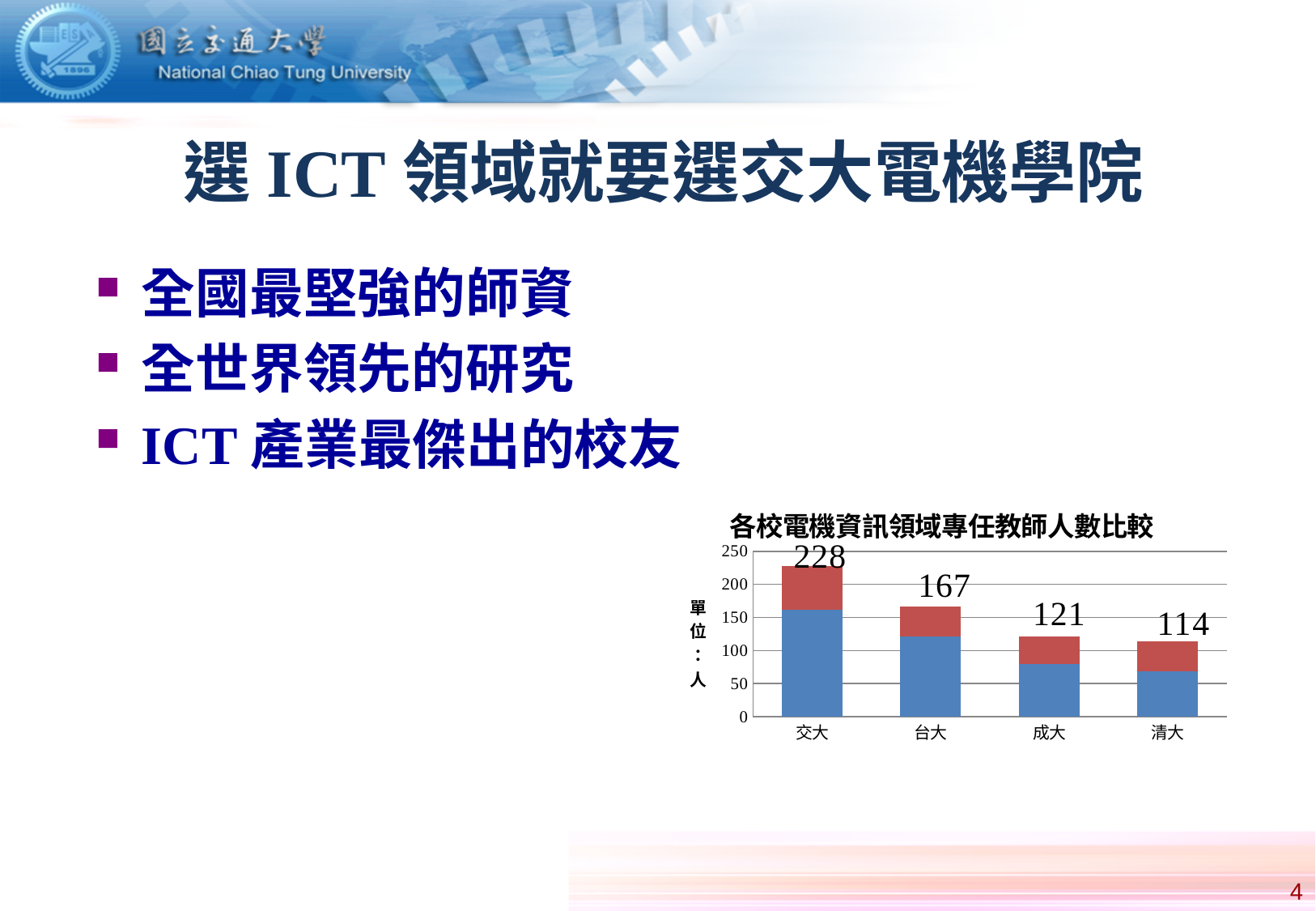
How many universities are compared in the chart? 4 Is the value of the blue segment for 交大 greater or less than 150? greater What kind of chart is shown on the slide? Stacked bar chart What is the total value shown for 清大? 114 Which is larger, the total for 成大 or the total for 清大? 成大 Do the totals rise or fall from left to right across the x axis? Fall What is the total value shown for 交大? 228 Which university has the highest total number of faculty in the chart? 交大 Which university has the lowest total number of faculty in the chart? 清大 What is the difference between the totals for 交大 and 台大? 61 What is the total value shown for 台大? 167 Is the value of the blue segment for 成大 greater or less than 100? less